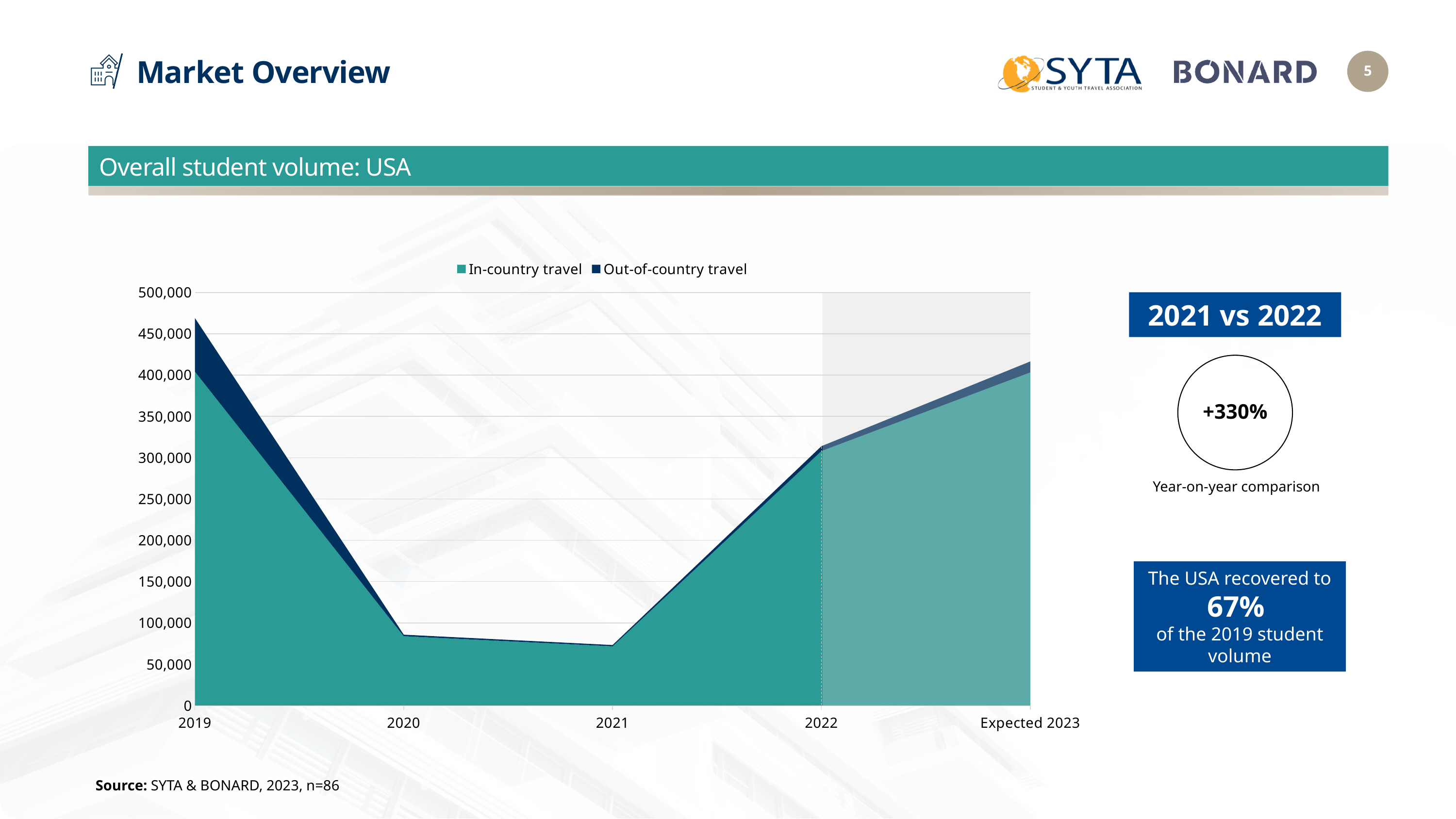
What kind of chart is shown on the slide? Area chart How many time points are shown on the x axis? 5 Is the overall student volume for 2021 greater or less than 100,000? less How many series does the legend list? 2 Which year has the highest overall student volume? 2019 Which is larger, the overall student volume in 2019 or in 2022? 2019 Is the overall student volume for 2019 greater or less than 450,000? greater What is the title of the chart? Overall student volume: USA Which year has the lowest overall student volume? 2021 Is the overall student volume for 2020 greater or less than 150,000? less Does the overall student volume rise or fall from 2021 to Expected 2023? Rise